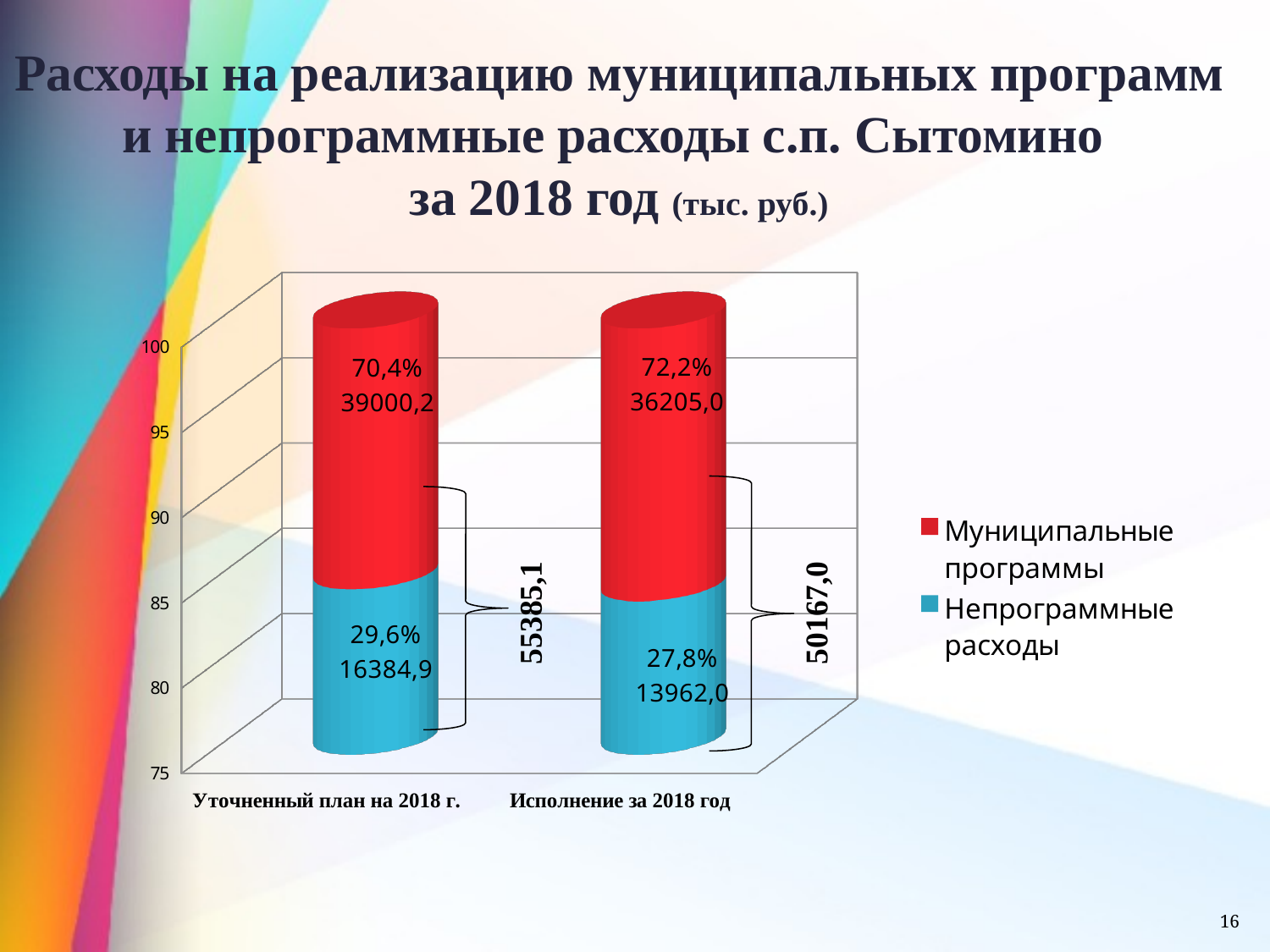
What is the total shown for the Уточненный план на 2018 г. bar? 55385,1 What value is shown for Муниципальные программы in Уточненный план на 2018 г.? 39000,2 What percentage share is shown for Непрограммные расходы in Уточненный план на 2018 г.? 29,6% What kind of chart is shown on the slide? Stacked bar chart What is the difference between the Муниципальные программы values for Уточненный план на 2018 г. and Исполнение за 2018 год? 2795,2 Which category has the larger value for Муниципальные программы, Уточненный план на 2018 г. or Исполнение за 2018 год? Уточненный план на 2018 г. How many series does the chart legend list? 2 How many categories are shown on the x axis of the chart? 2 What value is shown for Непрограммные расходы in Исполнение за 2018 год? 13962,0 What is the total shown for the Исполнение за 2018 год bar? 50167,0 What percentage share is shown for Муниципальные программы in Исполнение за 2018 год? 72,2% What is the difference between the Непрограммные расходы values for Уточненный план на 2018 г. and Исполнение за 2018 год? 2422,9